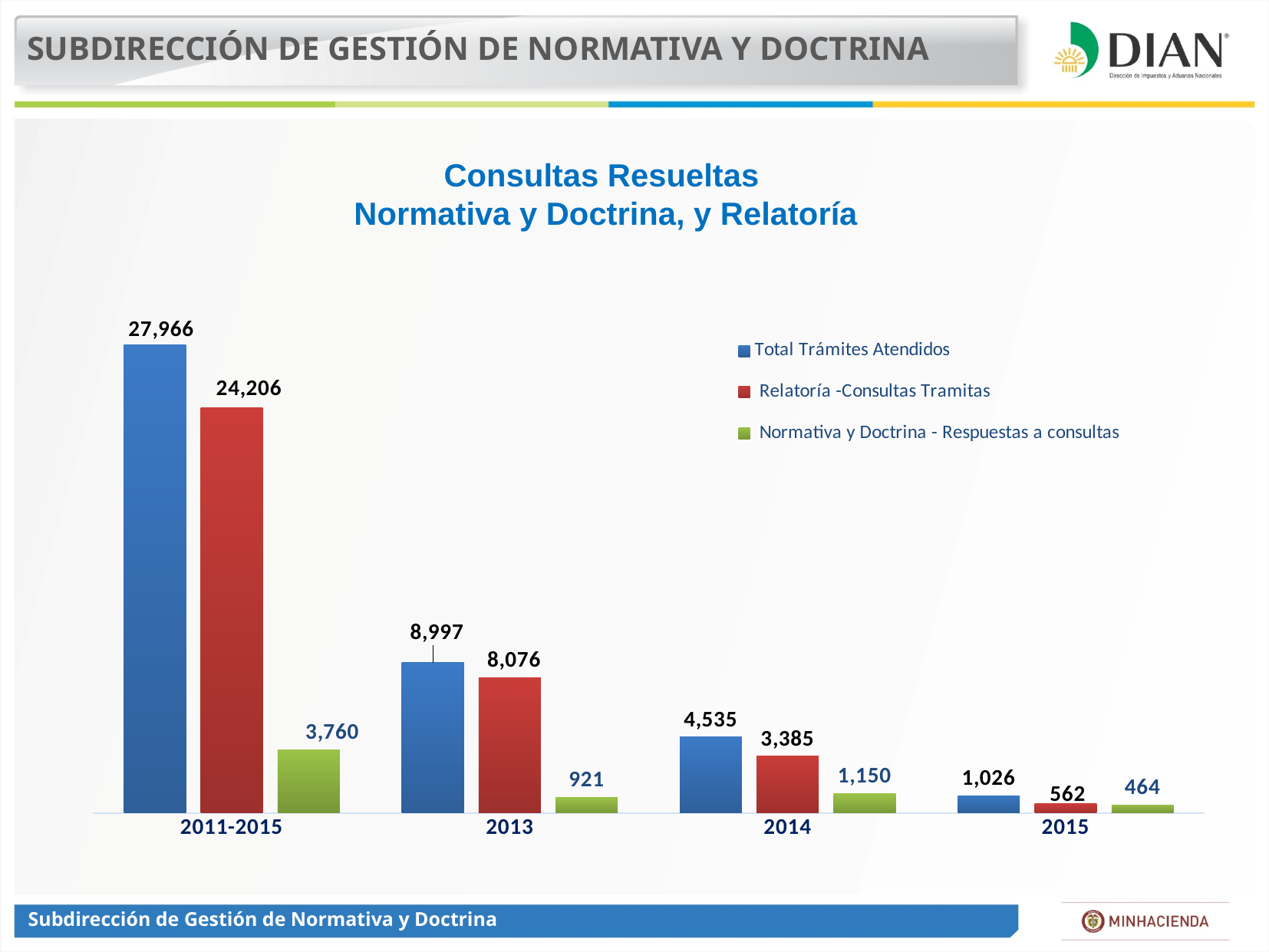
Which is larger for 2013: Relatoría -Consultas Tramitas or Normativa y Doctrina - Respuestas a consultas? Relatoría -Consultas Tramitas What is the title of the chart? Consultas Resueltas Normativa y Doctrina, y Relatoría How many categories are shown on the x axis? 4 Which category has the highest value for Total Trámites Atendidos? 2011-2015 What is the value of Total Trámites Atendidos for 2011-2015? 27,966 What is the value of Normativa y Doctrina - Respuestas a consultas for 2014? 1,150 What kind of chart is shown on the slide? Bar chart Which category has the lowest value for Normativa y Doctrina - Respuestas a consultas? 2015 What is the value of Relatoría -Consultas Tramitas for 2015? 562 How many series does the legend list? 3 What is the value of Relatoría -Consultas Tramitas for 2013? 8,076 What is the difference between Total Trámites Atendidos and Relatoría -Consultas Tramitas for 2014? 1,150